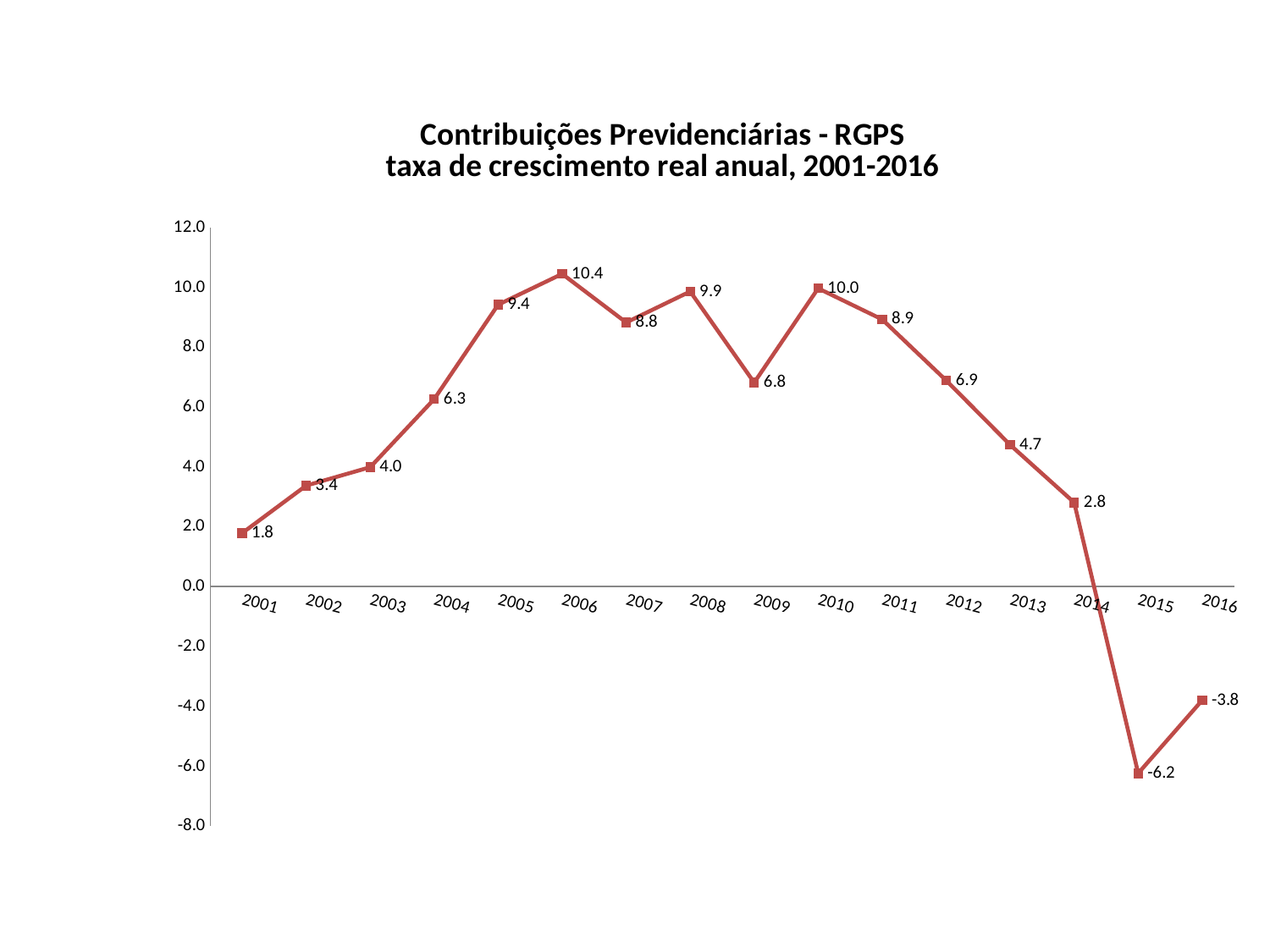
Which year has the lowest value? 2015 What is the value for 2015? -6.2 What kind of chart is shown? line chart Which year has the highest value? 2006 What is the value for 2001? 1.8 Which is larger, the value for 2005 or the value for 2007? 2005 What is the difference between the values for 2010 and 2009? 3.2 How many years are plotted on the chart? 16 Is the value for 2012 greater or less than 6.0? greater Do the values rise or fall from 2011 to 2015? fall What is the value for 2006? 10.4 What is the title of the chart? Contribuições Previdenciárias - RGPS taxa de crescimento real anual, 2001-2016